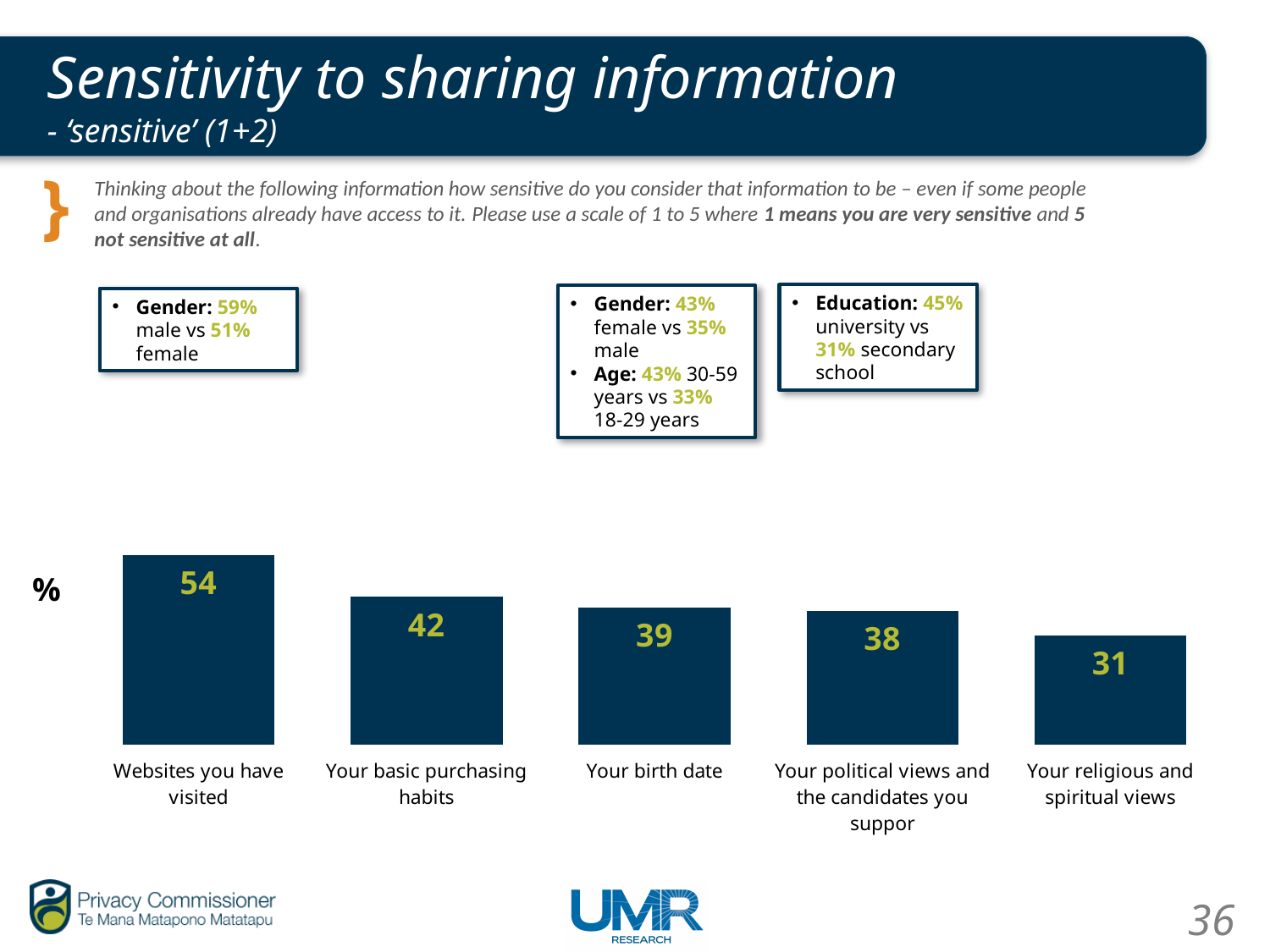
What is the value for 'Your birth date'? 39 What is the value for 'Your basic purchasing habits'? 42 What is the value for 'Websites you have visited'? 54 Which category has the lowest value? Your religious and spiritual views What is the difference between the values for 'Websites you have visited' and 'Your religious and spiritual views'? 23 What kind of chart is shown on the slide? Bar chart Which category has the highest value? Websites you have visited What is the difference between the values for 'Your basic purchasing habits' and 'Your birth date'? 3 Which is larger: the value for 'Your birth date' or the value for 'Your political views and the candidates you suppor'? Your birth date How many categories are shown in the chart? 5 Do the values rise or fall from left to right across the chart? Fall What is the value for 'Your religious and spiritual views'? 31